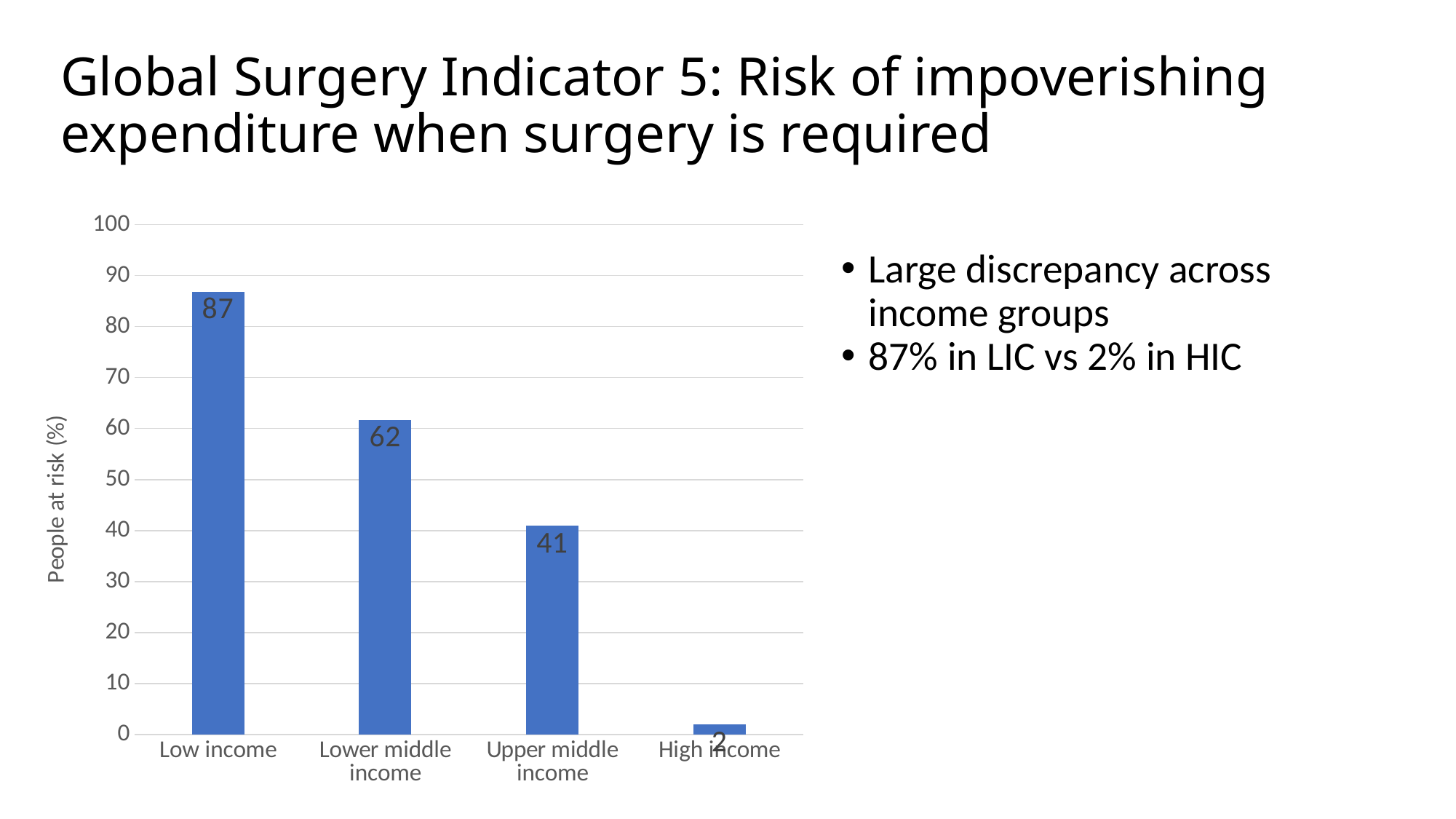
Which is larger, the value for Lower middle income or Upper middle income? Lower middle income What kind of chart is shown on the slide? Bar chart Which income group has the highest value? Low income What is the difference between the values for Lower middle income and Upper middle income? 21 Which income group has the lowest value? High income What is the value for Lower middle income? 62 What is the value for High income? 2 What is the value for Low income? 87 What is the label of the vertical axis? People at risk (%) What is the difference between the values for Low income and High income? 85 How many income groups are shown on the chart? 4 What is the value for Upper middle income? 41